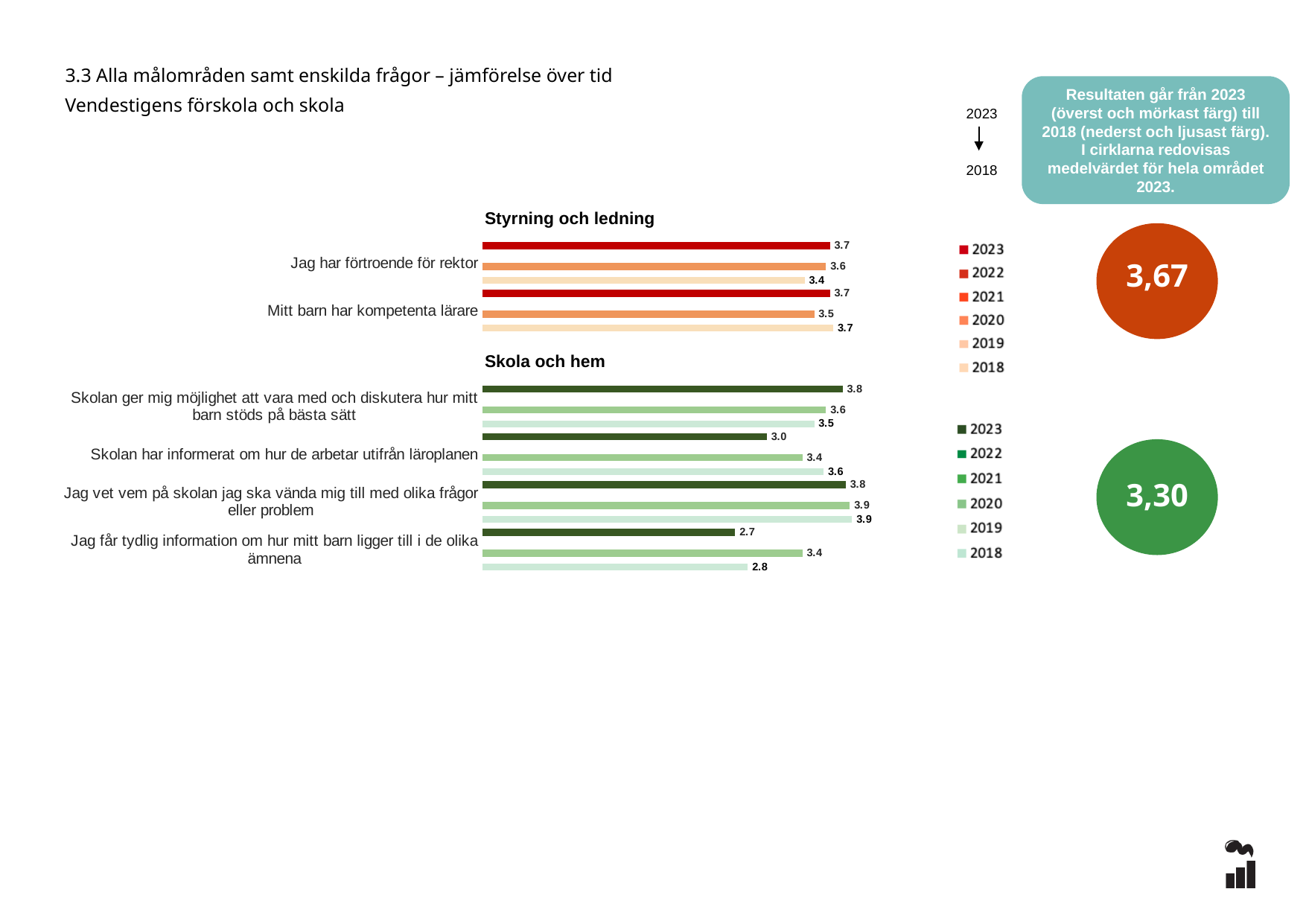
What kind of chart is used for 'Styrning och ledning'? Bar chart In the 'Skola och hem' chart, what is the value of the darkest (2023) bar for 'Skolan har informerat om hur de arbetar utifrån läroplanen'? 3.0 In the 'Styrning och ledning' chart, what is the value of the lightest (bottom) bar for 'Mitt barn har kompetenta lärare'? 3.7 In the 'Skola och hem' chart, which has the larger 2023 (darkest bar) value: 'Skolan ger mig möjlighet att vara med och diskutera hur mitt barn stöds på bästa sätt' or 'Skolan har informerat om hur de arbetar utifrån läroplanen'? Skolan ger mig möjlighet att vara med och diskutera hur mitt barn stöds på bästa sätt What mean value is shown in the green circle next to the 'Skola och hem' chart? 3,30 In the 'Skola och hem' chart, what is the difference between the middle bar (3.4) and the darkest 2023 bar (2.7) for 'Jag får tydlig information om hur mitt barn ligger till i de olika ämnena'? 0.7 How many years does the legend of the 'Styrning och ledning' chart list? 6 In the 'Styrning och ledning' chart, what is the value of the darkest (2023) bar for 'Jag har förtroende för rektor'? 3.7 In the 'Skola och hem' chart, which question has the highest value of any bar? Jag vet vem på skolan jag ska vända mig till med olika frågor eller problem In the 'Skola och hem' chart, which question has the lowest 2023 (darkest bar) value? Jag får tydlig information om hur mitt barn ligger till i de olika ämnena In the 'Skola och hem' chart, what is the value of the darkest (2023) bar for 'Jag får tydlig information om hur mitt barn ligger till i de olika ämnena'? 2.7 How many questions (categories) are shown in the 'Skola och hem' chart? 4